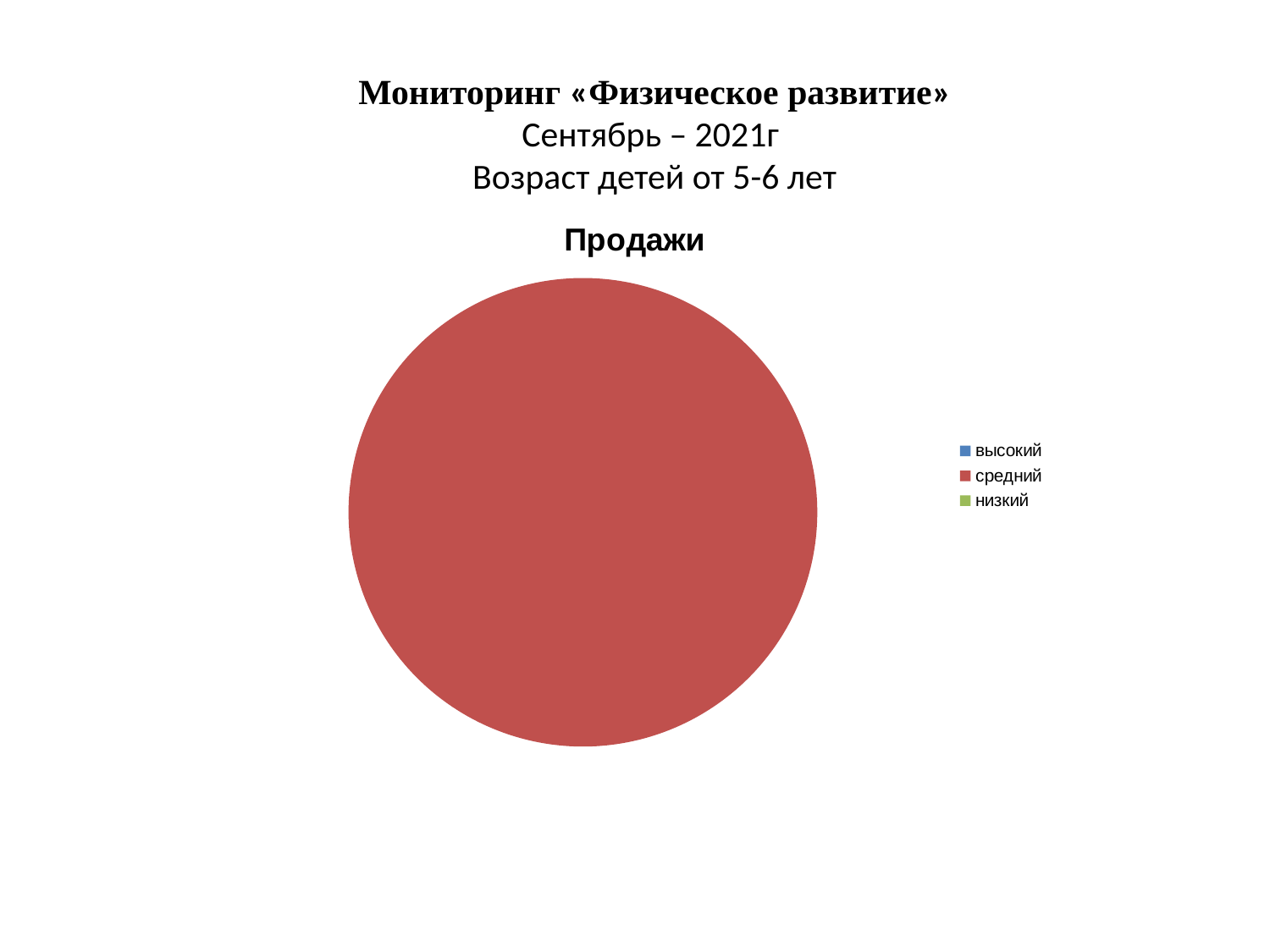
What kind of chart is shown on the slide? pie chart Which colour represents the category средний in the chart? red Which of the two categories, низкий or средний, has the larger share of the pie? средний Which of the two categories, средний or высокий, has the larger share of the pie? средний How many entries does the chart legend list? 3 Which category takes up the largest share of the pie? средний What is the title of the chart? Продажи